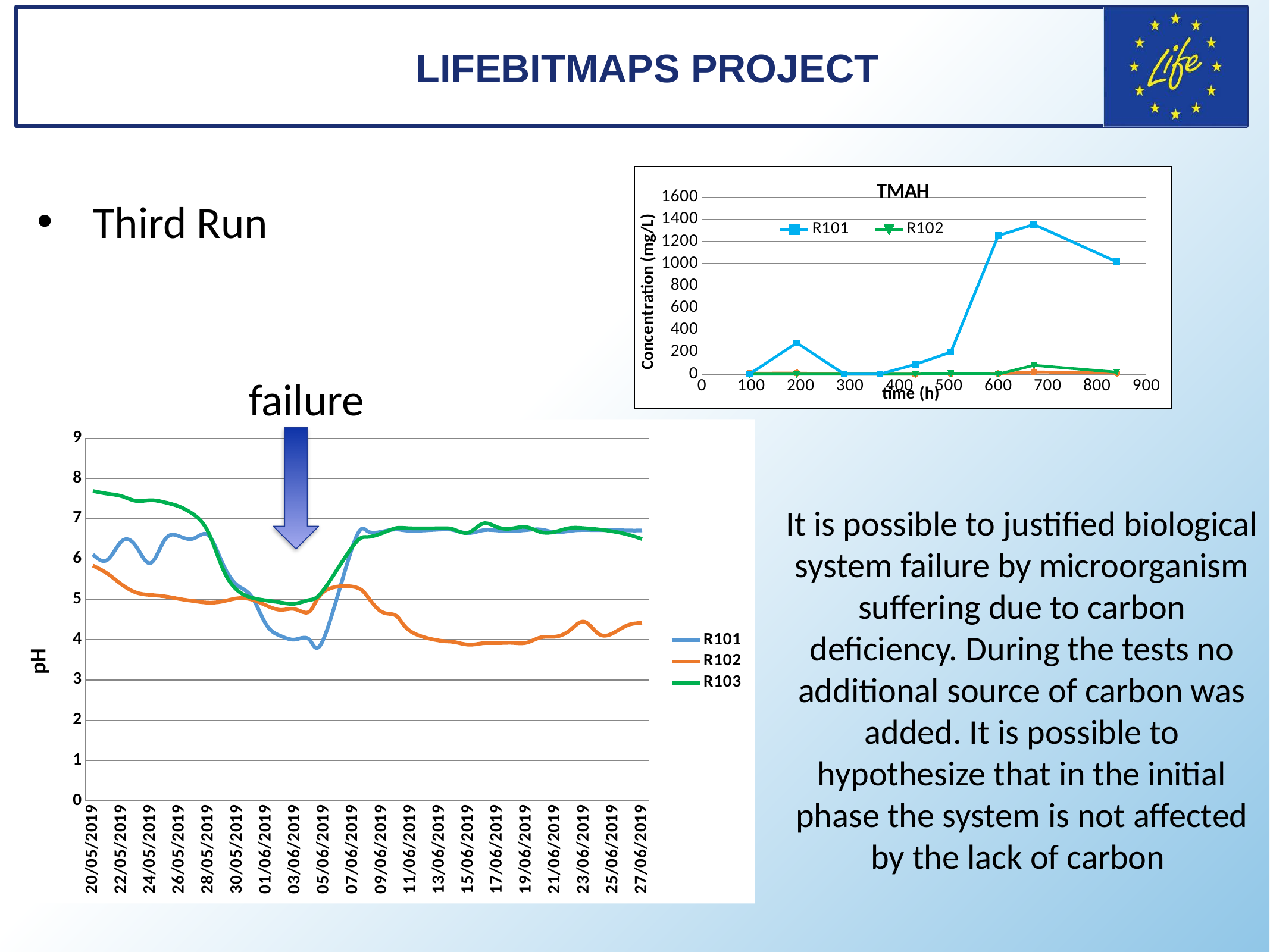
What is the y-axis label of the TMAH chart? Concentration (mg/L) In the TMAH chart, is the R101 value at about 600 h greater or less than 1000? greater How many series does the legend of the TMAH chart list? 2 In the pH chart, does the R102 series rise or fall overall from 20/05/2019 to 27/06/2019? fall How many series does the legend of the pH chart list? 3 What kind of chart is the TMAH chart? line chart In the TMAH chart, is the R101 value at about 670 h greater or less than 1200? greater In the pH chart, is the R101 value on 05/06/2019 greater or less than 5? less In the pH chart, which series has the highest pH on 20/05/2019? R103 In the TMAH chart, which series reaches the higher concentration, R101 or R102? R101